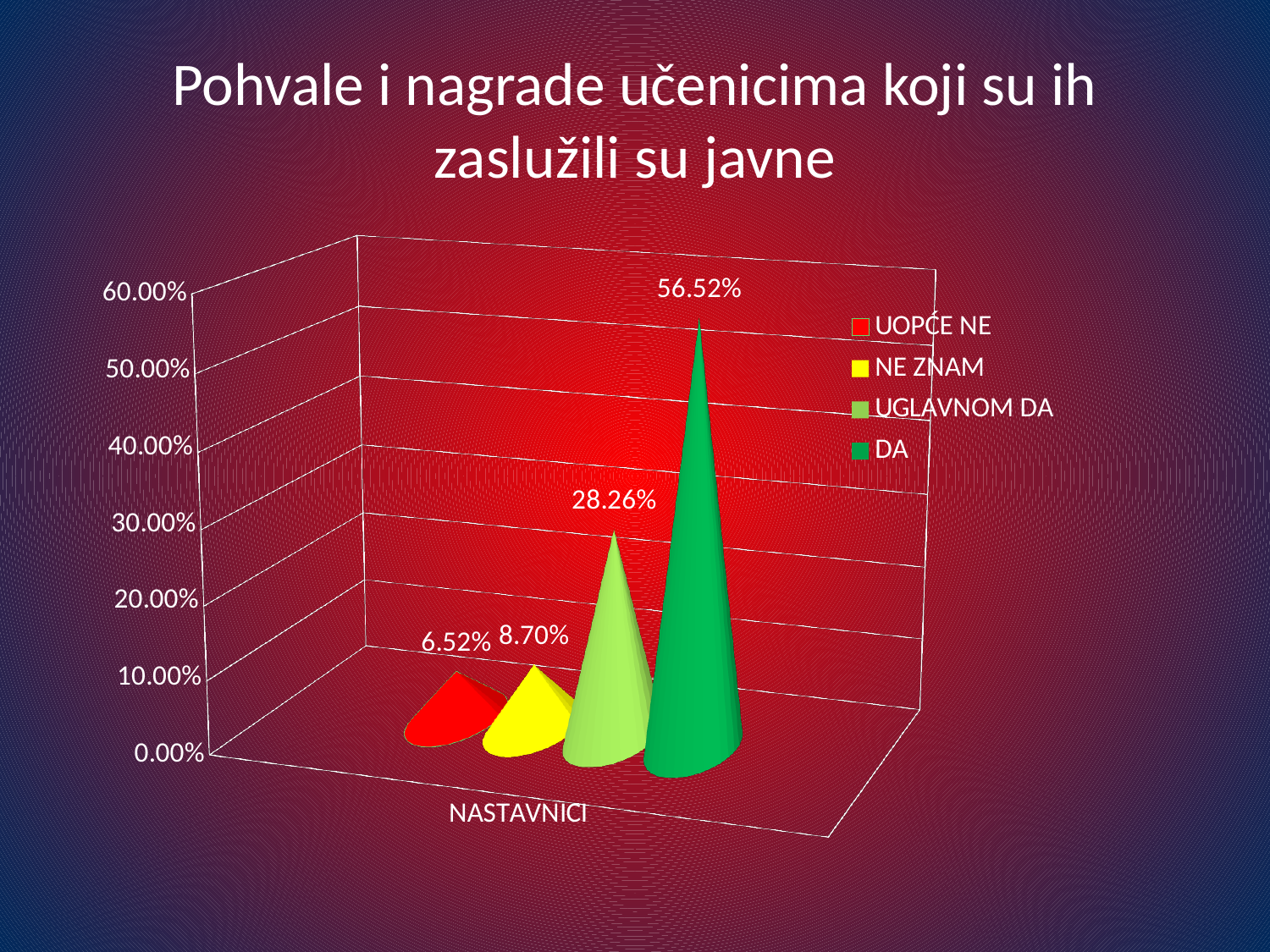
What is the value for NE ZNAM? 8.70% Is the value for DA greater or less than 50.00%? greater What is the value for UGLAVNOM DA? 28.26% How many series does the legend list? 4 What is the value for UOPĆE NE? 6.52% What is the value for DA? 56.52% Which series has the highest value? DA What is the category label shown on the x axis? NASTAVNICI Which is larger, the value for NE ZNAM or the value for UOPĆE NE? NE ZNAM What is the difference between the values for DA and UGLAVNOM DA? 28.26% What kind of chart is shown on the slide? bar chart Which series has the lowest value? UOPĆE NE